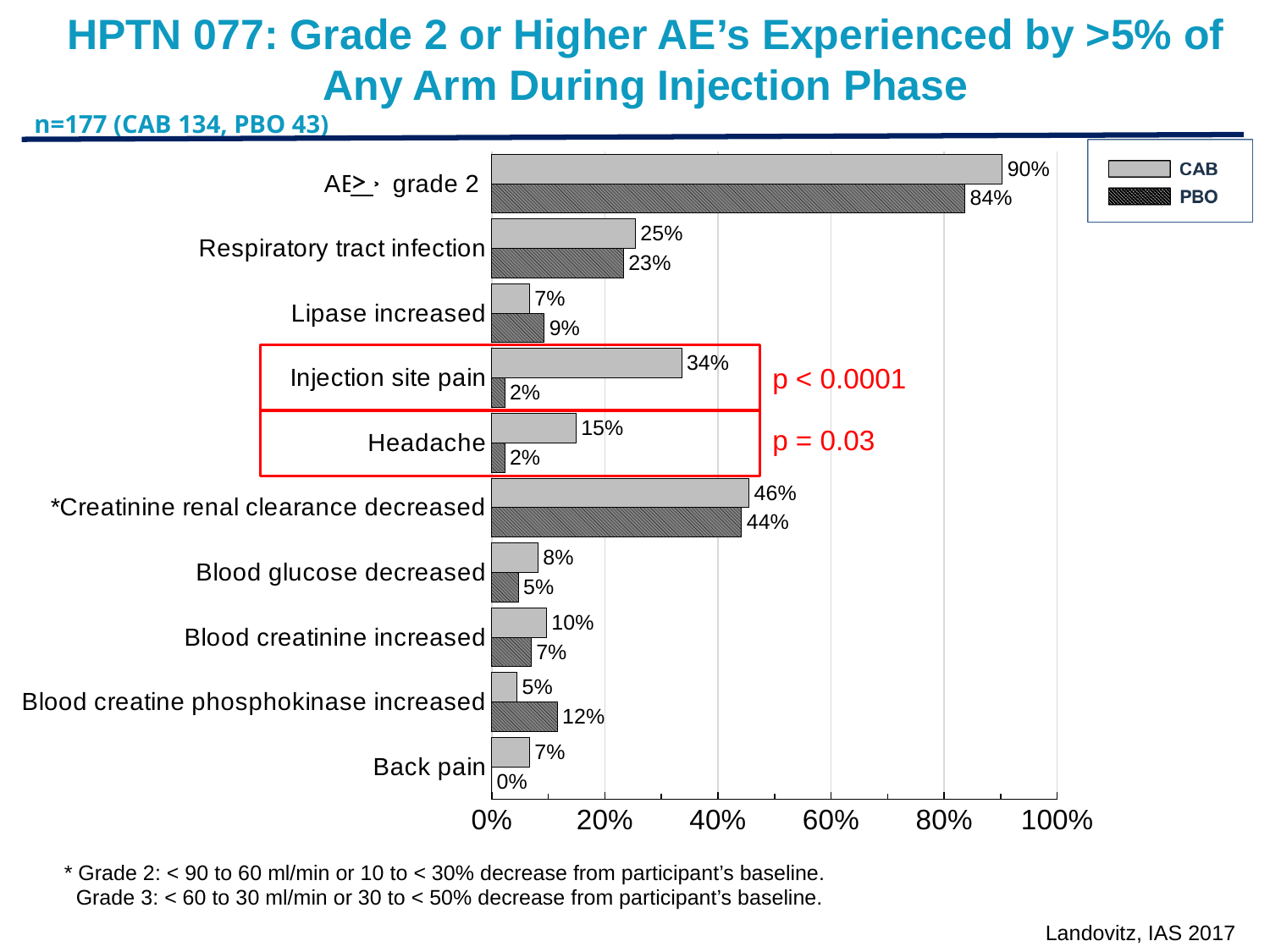
What is the difference between the CAB and PBO values for Injection site pain? 32% What is the PBO value for Back pain? 0% What is the difference between the CAB and PBO values for Headache? 13% Which category has the lowest PBO value? Back pain What is the CAB value for Injection site pain? 34% Which category has the highest CAB value? AE ≥ grade 2 How many adverse event categories are shown on the chart? 10 What is the PBO value for Respiratory tract infection? 23% What kind of chart is shown on the slide? Bar chart What p-value is shown next to the Injection site pain bars? p < 0.0001 For Blood creatine phosphokinase increased, which arm has the larger value, CAB or PBO? PBO How many series does the legend list? 2